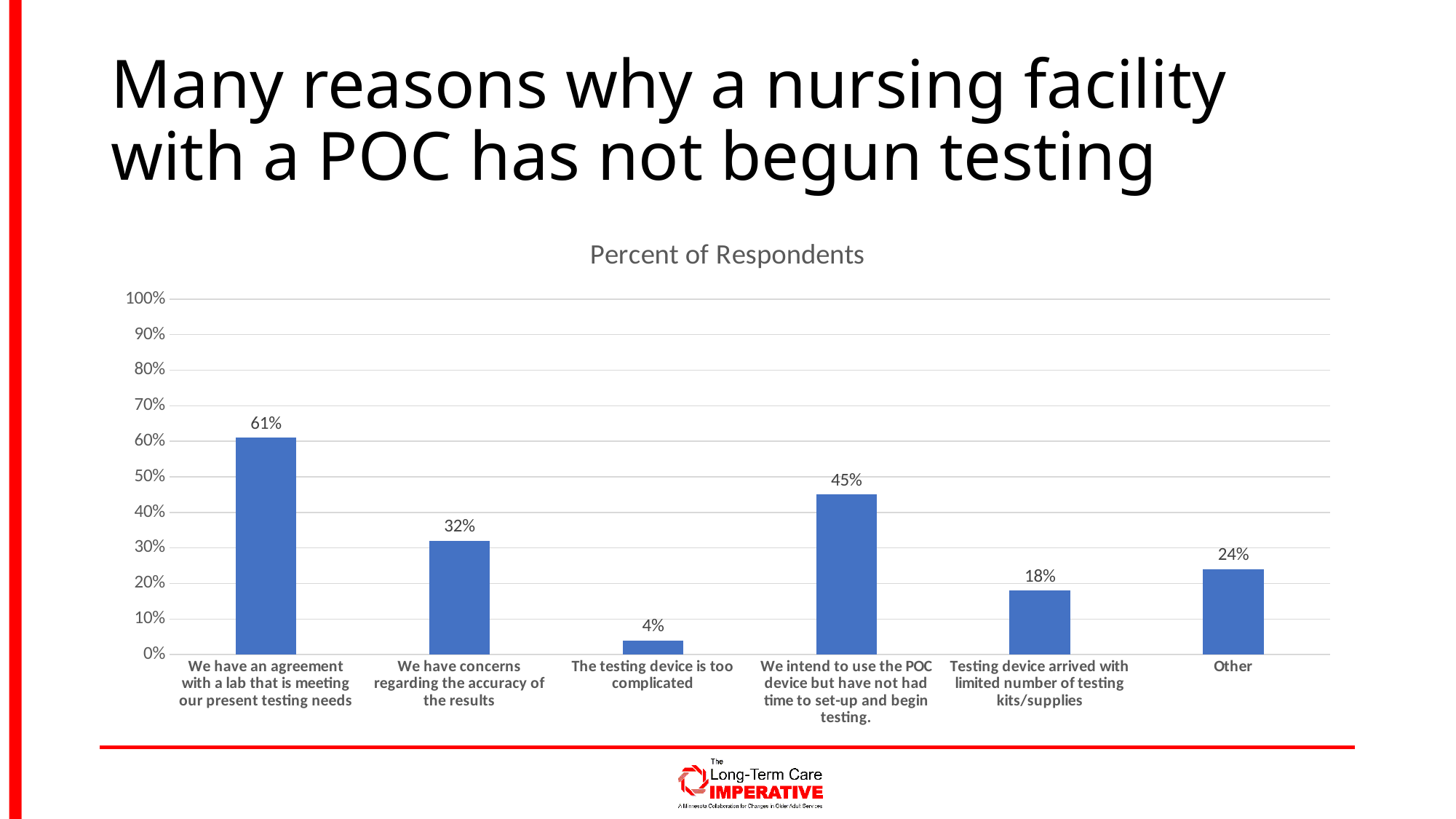
Is the value for 'We have concerns regarding the accuracy of the results' greater or less than 40%? less Which reason has the lowest percent of respondents? The testing device is too complicated What is the difference between the percent for 'We intend to use the POC device but have not had time to set-up and begin testing' and 'We have concerns regarding the accuracy of the results'? 13% What is the value for the 'Other' category? 24% What is the title of the chart? Percent of Respondents What percent of respondents said they have an agreement with a lab that is meeting their present testing needs? 61% What percent of respondents said the testing device arrived with a limited number of testing kits/supplies? 18% Which reason has the highest percent of respondents? We have an agreement with a lab that is meeting our present testing needs How many reason categories are shown on the chart? 6 What percent of respondents said the testing device is too complicated? 4% What kind of chart is shown on the slide? Bar chart Which is larger: the percent for 'Other' or the percent for 'Testing device arrived with limited number of testing kits/supplies'? Other